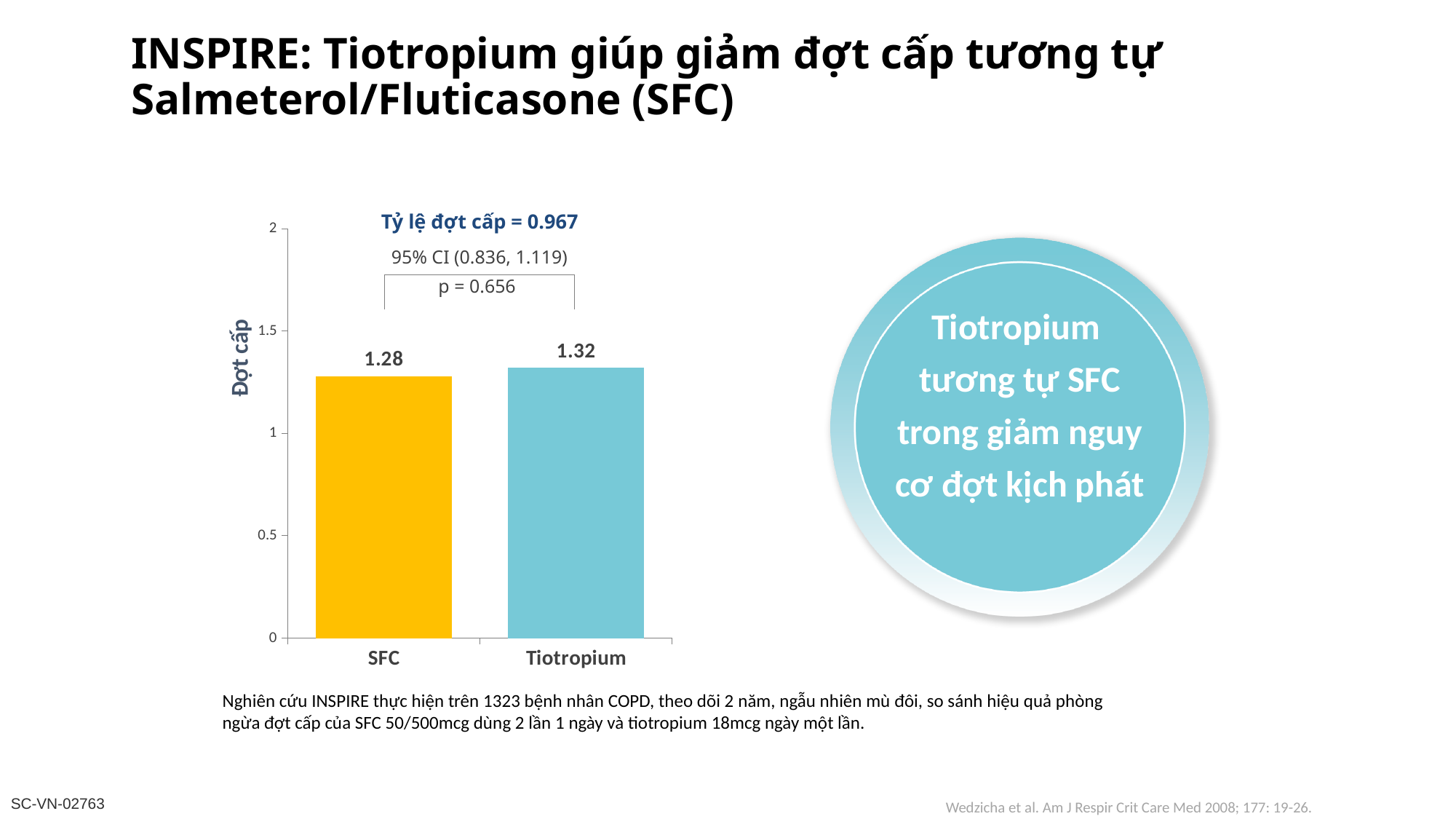
What kind of chart is shown on the slide? bar chart Which category has the highest value? Tiotropium Is the value for Tiotropium greater or less than 1? greater Is the value for SFC greater or less than 1.5? less Which is larger, the value for SFC or the value for Tiotropium? Tiotropium Which category has the lowest value? SFC What is the value for SFC? 1.28 What is the difference between the values for Tiotropium and SFC? 0.04 What is the value for Tiotropium? 1.32 How many categories are shown on the x axis? 2 What p value is shown above the bars? p = 0.656 What is the label of the y axis? Đợt cấp